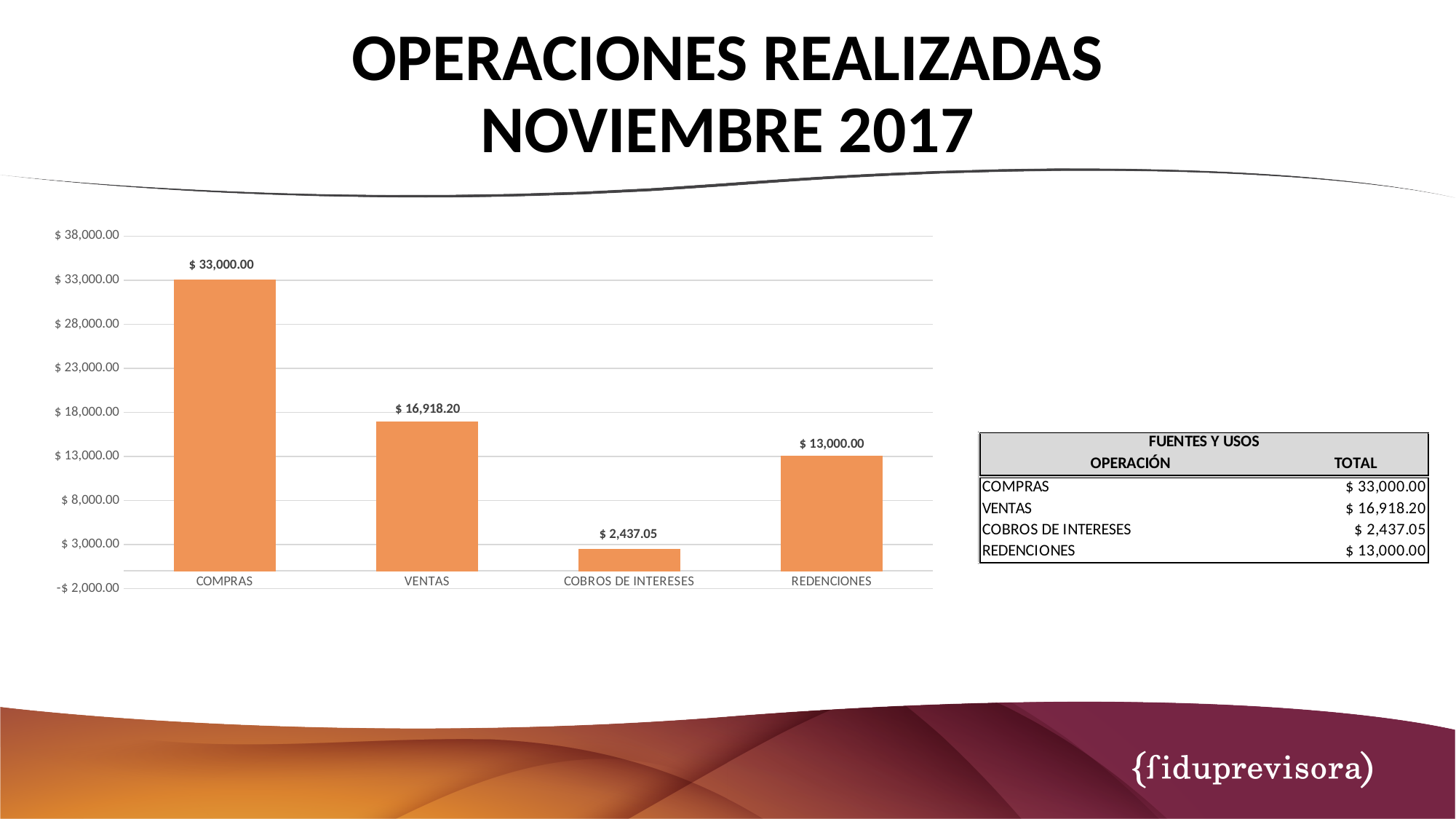
What is the value for COMPRAS? $ 33,000.00 What kind of chart is shown on the slide? Bar chart What is the difference between the values for VENTAS and REDENCIONES? $ 3,918.20 What is the value for VENTAS? $ 16,918.20 Which category has the lowest value? COBROS DE INTERESES Which is larger, the value for VENTAS or the value for REDENCIONES? VENTAS What is the difference between the values for COMPRAS and REDENCIONES? $ 20,000.00 What is the value for REDENCIONES? $ 13,000.00 What is the value for COBROS DE INTERESES? $ 2,437.05 What is the title of the slide? OPERACIONES REALIZADAS NOVIEMBRE 2017 Which category has the highest value? COMPRAS How many categories are shown on the chart? 4